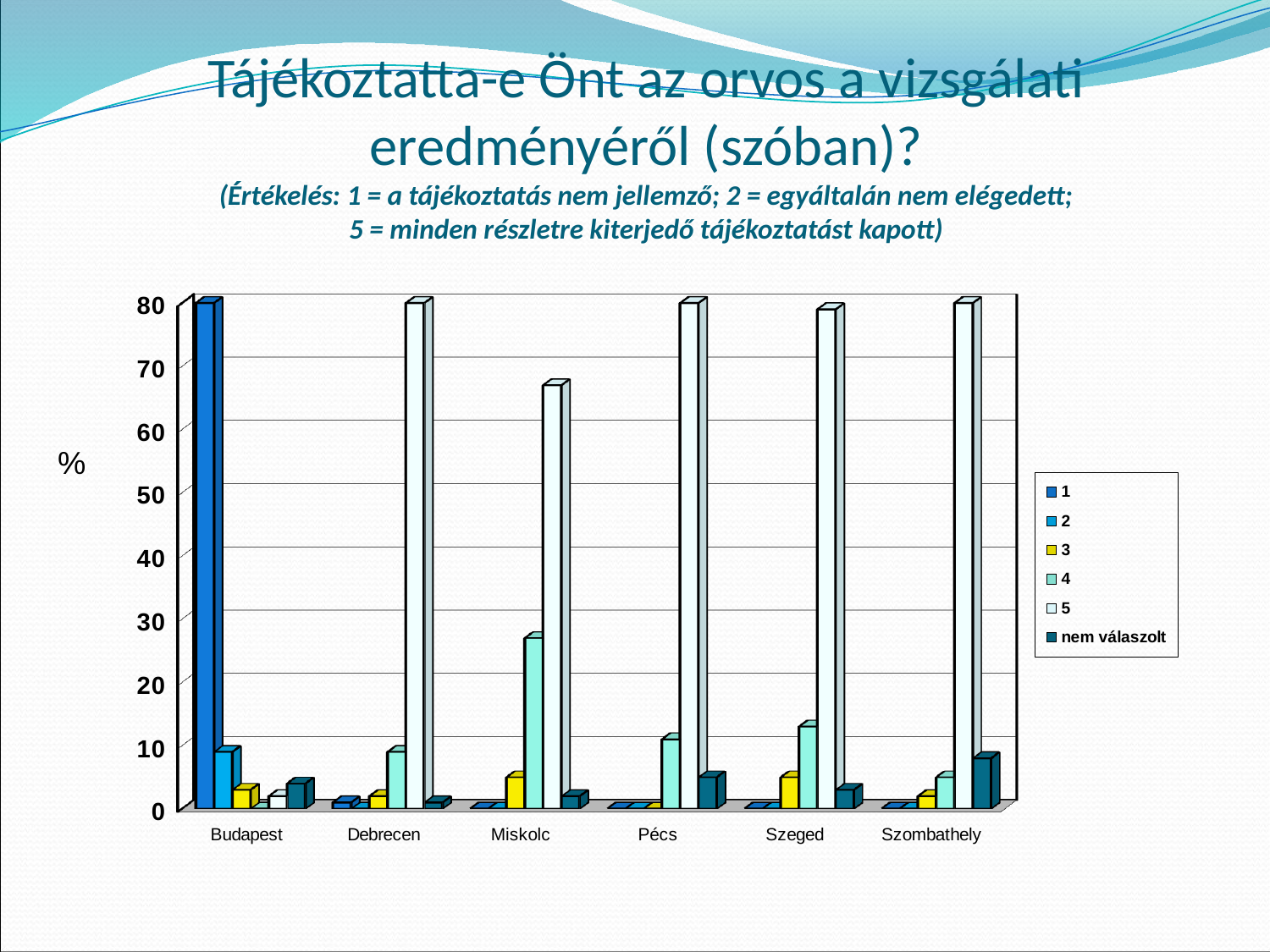
How many series does the chart's legend list? 6 Which city has the highest value for series 4? Miskolc How many cities are shown on the x axis of the chart? 6 Is the value for series 5 in Miskolc greater or less than 70? less Is the value for series 4 in Miskolc greater or less than 20? greater Is the value for series 5 in Pécs greater or less than 70? greater Which is larger: the value for series 4 in Miskolc or the value for series 4 in Szeged? Miskolc What kind of chart is shown on the slide? bar chart What is the last entry in the chart's legend? nem válaszolt Which city has the lowest value for series 5? Budapest Which series has the highest value in Budapest? 1